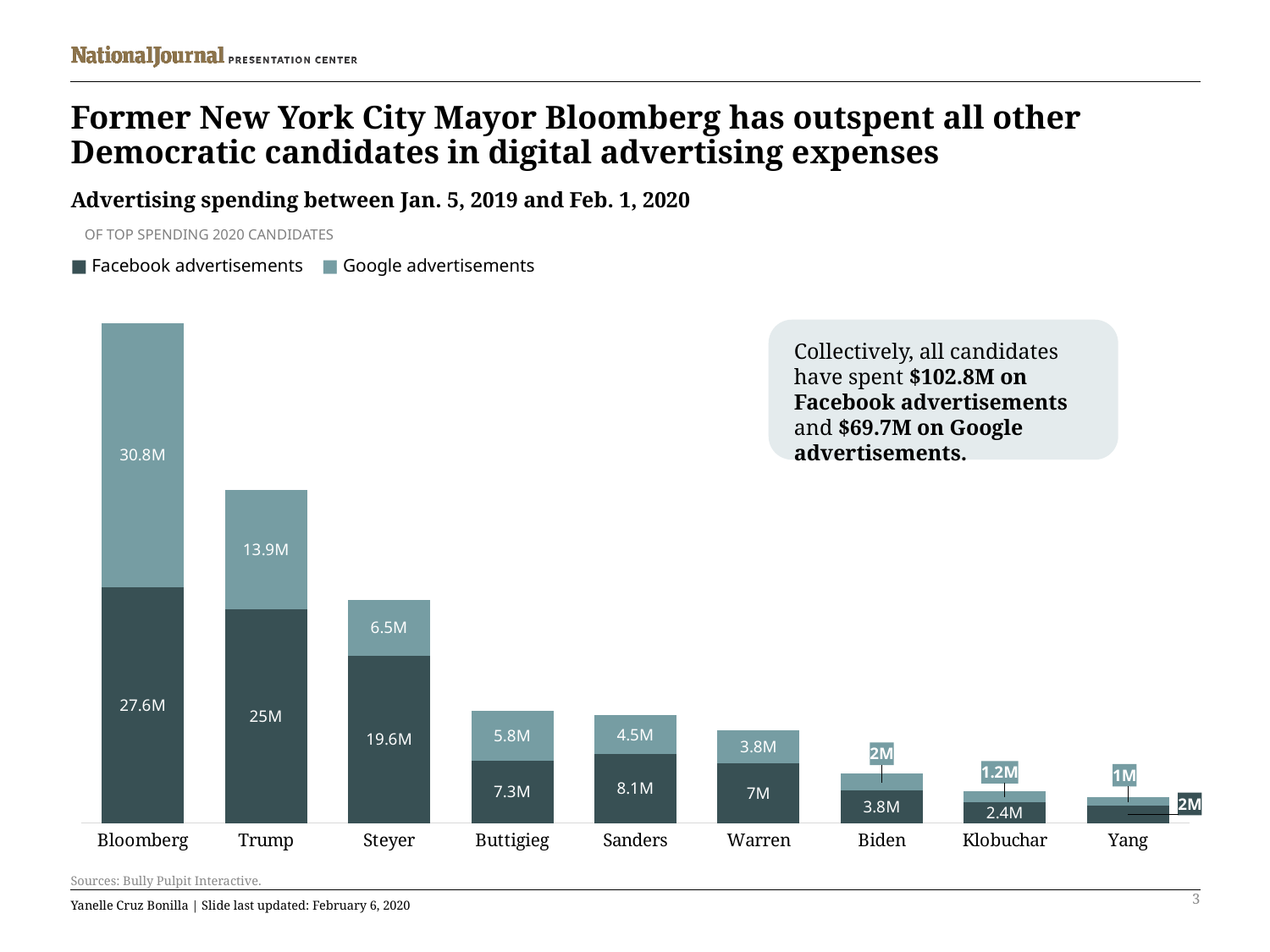
How many series does the legend list? 2 What is the difference between Bloomberg's Google and Facebook advertisement spending? 3.2M How much did Trump spend on Facebook advertisements? 25M What kind of chart is shown on the slide? Stacked bar chart Who spent more on Facebook advertisements, Sanders or Buttigieg? Sanders Which candidate has the highest Facebook advertisement spending? Bloomberg How many candidates are shown on the x axis? 9 Which candidate has the lowest Google advertisement spending? Yang What is the total advertising spending shown for Steyer? 26.1M How much did Sanders spend on Google advertisements? 4.5M Which series is shown in the darker colour in the legend? Facebook advertisements How much did Bloomberg spend on Google advertisements? 30.8M